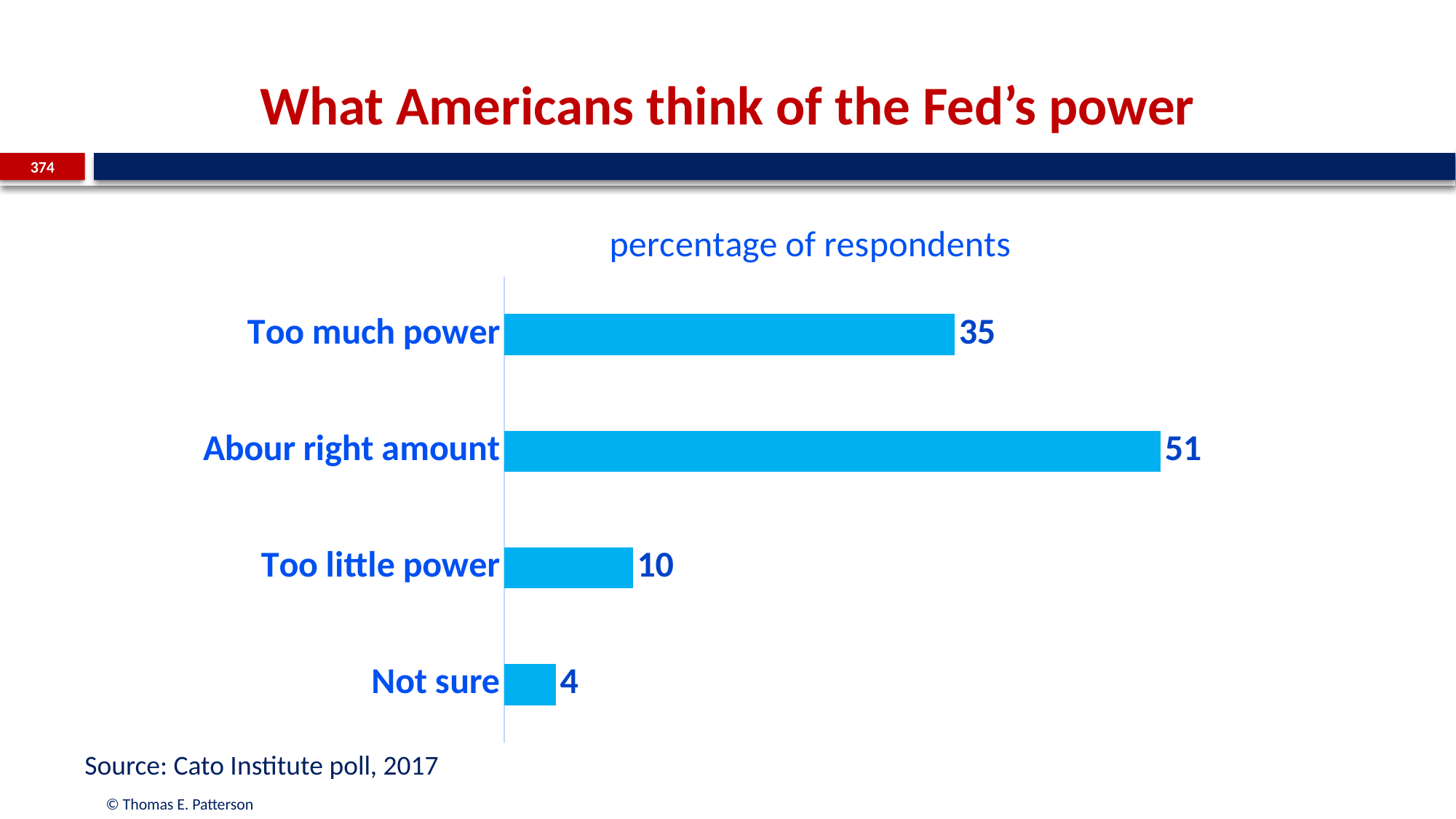
Which response has the lowest percentage of respondents? Not sure Which is larger: the percentage for 'Too much power' or for 'Too little power'? Too much power What percentage of respondents said the Fed has too little power? 10 What is the difference in percentage points between 'Abour right amount' and 'Too much power'? 16 What percentage of respondents said the Fed has too much power? 35 Which response has the highest percentage of respondents? Abour right amount How many response categories are shown in the chart? 4 What is the difference in percentage points between 'Too little power' and 'Not sure'? 6 What is the title of the chart? percentage of respondents What kind of chart is shown on the slide? Bar chart What percentage of respondents said the Fed has about the right amount of power? 51 What percentage of respondents were not sure? 4